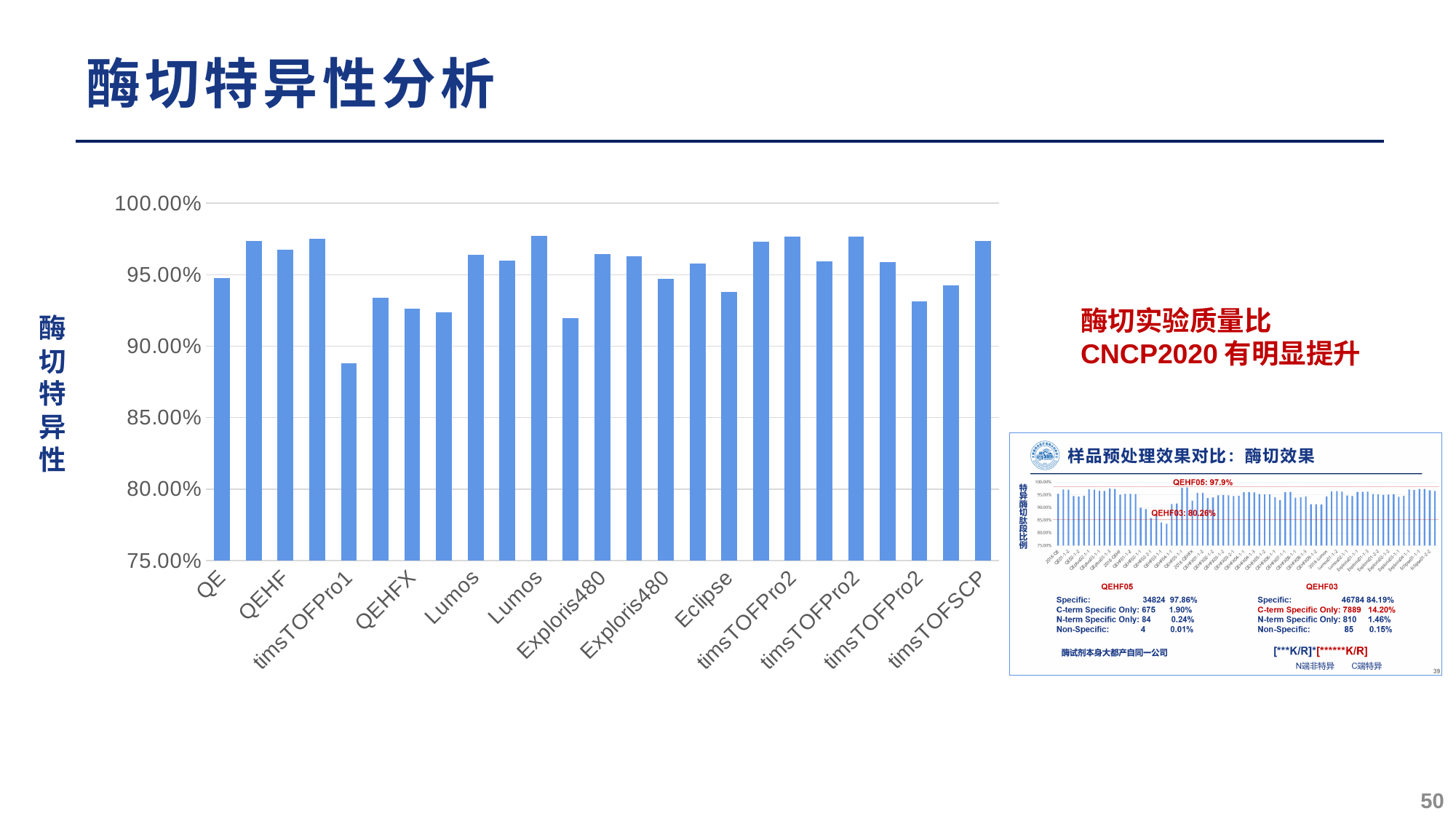
What is the highest value shown on the y axis of the large bar chart? 100.00% In the large bar chart, which is larger, the value for QEHFX or the value for timsTOFSCP? timsTOFSCP In the small inset chart at the bottom right, what value is labelled for QEHF05? 97.9% What kind of chart is the large chart on the left of the slide? bar chart In the large bar chart, which is larger, the value for QE or the value for timsTOFPro1? QE In the small inset chart at the bottom right, what value is labelled for QEHF03? 80.26% In the large bar chart, is the value for timsTOFSCP greater or less than 95.00%? greater In the large bar chart, is the value for QE greater or less than 90.00%? greater In the large bar chart, is the value for Eclipse greater or less than 95.00%? less How many bars are plotted in the large bar chart? 25 In the large bar chart, which labelled category has the lowest value? timsTOFPro1